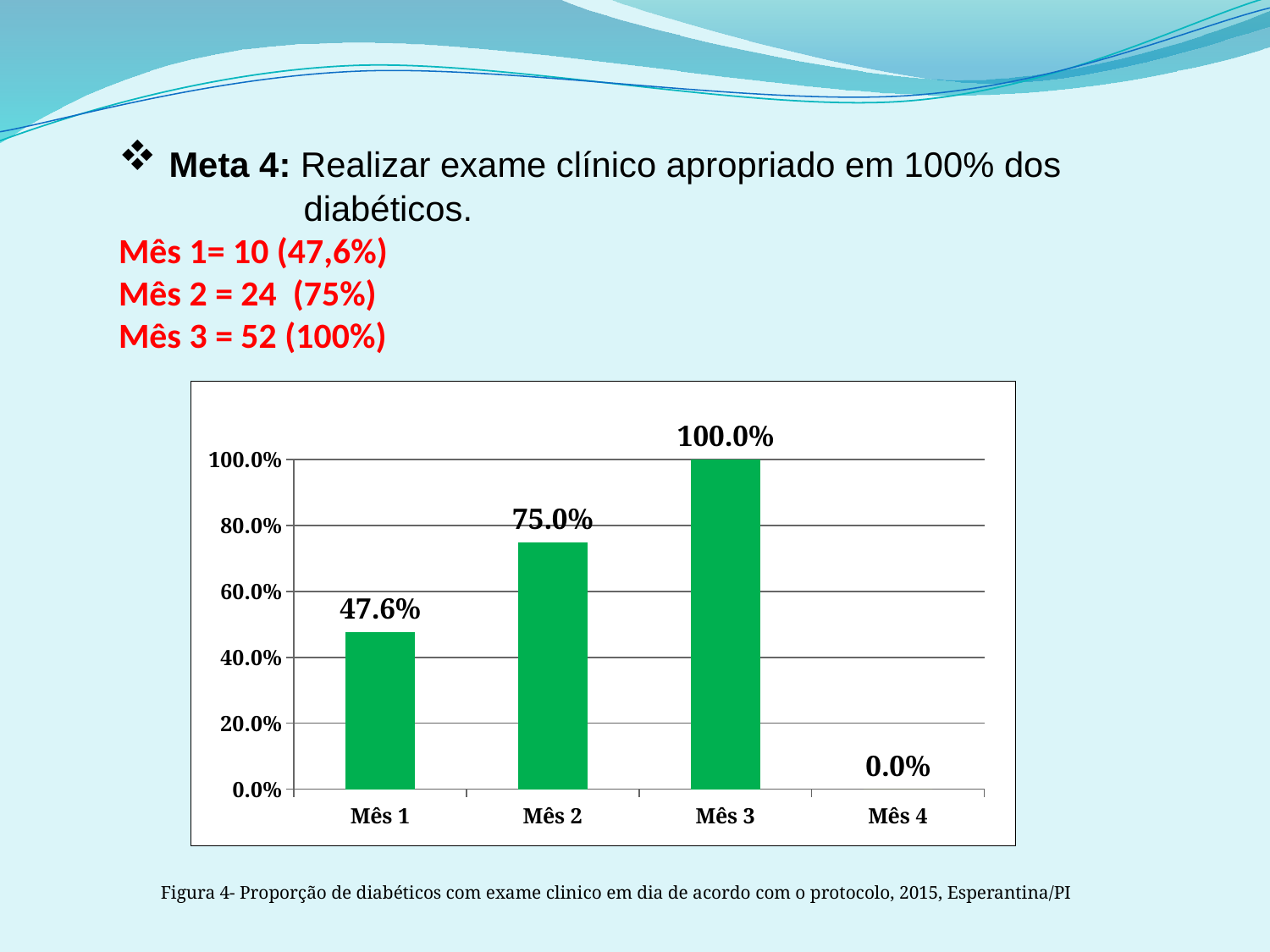
What is the difference between the values for Mês 3 and Mês 2? 25.0% How many months are shown on the x axis? 4 What is the value for Mês 4? 0.0% Which month has the highest value? Mês 3 What is the value for Mês 2? 75.0% Do the values rise or fall from Mês 1 to Mês 3? rise What is the value for Mês 1? 47.6% What kind of chart is shown? bar chart What is the difference between the values for Mês 2 and Mês 1? 27.4% Which month has the lowest value? Mês 4 What is the value for Mês 3? 100.0% Which is larger, the value for Mês 1 or the value for Mês 2? Mês 2